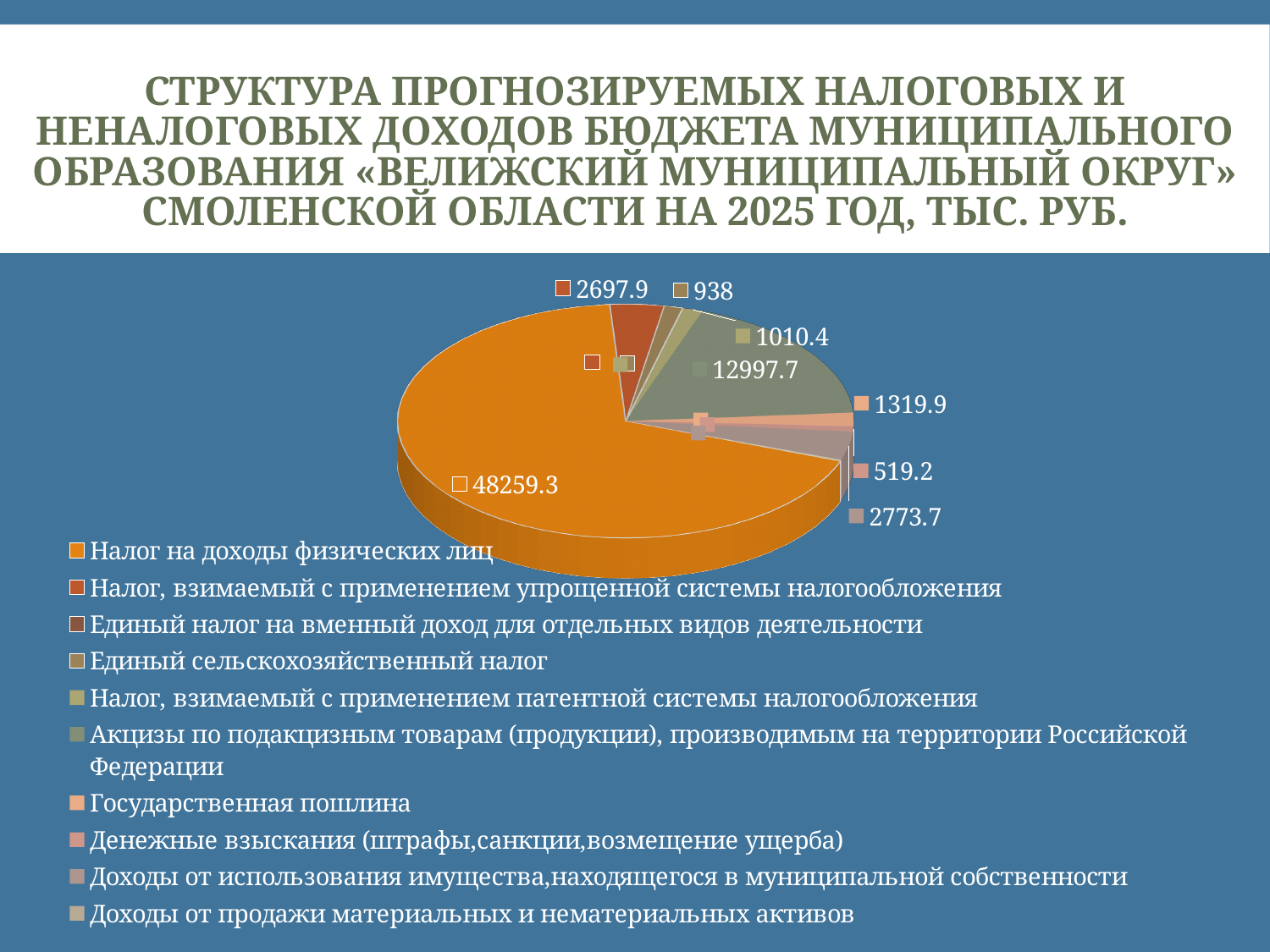
For which year does the chart show the forecast budget revenue structure? 2025 Which category has the largest slice of the pie chart? Налог на доходы физических лиц Which is larger: Налог на доходы физических лиц or Акцизы по подакцизным товарам? Налог на доходы физических лиц What is the value shown for Акцизы по подакцизным товарам (продукции), производимым на территории Российской Федерации? 12997.7 What is the value shown for Налог, взимаемый с применением упрощенной системы налогообложения? 2697.9 What is the smallest value printed as a data label on the pie chart? 519.2 What is the value shown for Налог на доходы физических лиц? 48259.3 What kind of chart is shown on the slide? pie chart In what units are the values in the chart expressed, according to the slide title? тыс. руб. How many categories does the legend of the pie chart list? 10 What is the difference between the value for Налог на доходы физических лиц (48259.3) and the value for Акцизы по подакцизным товарам (12997.7)? 35261.6